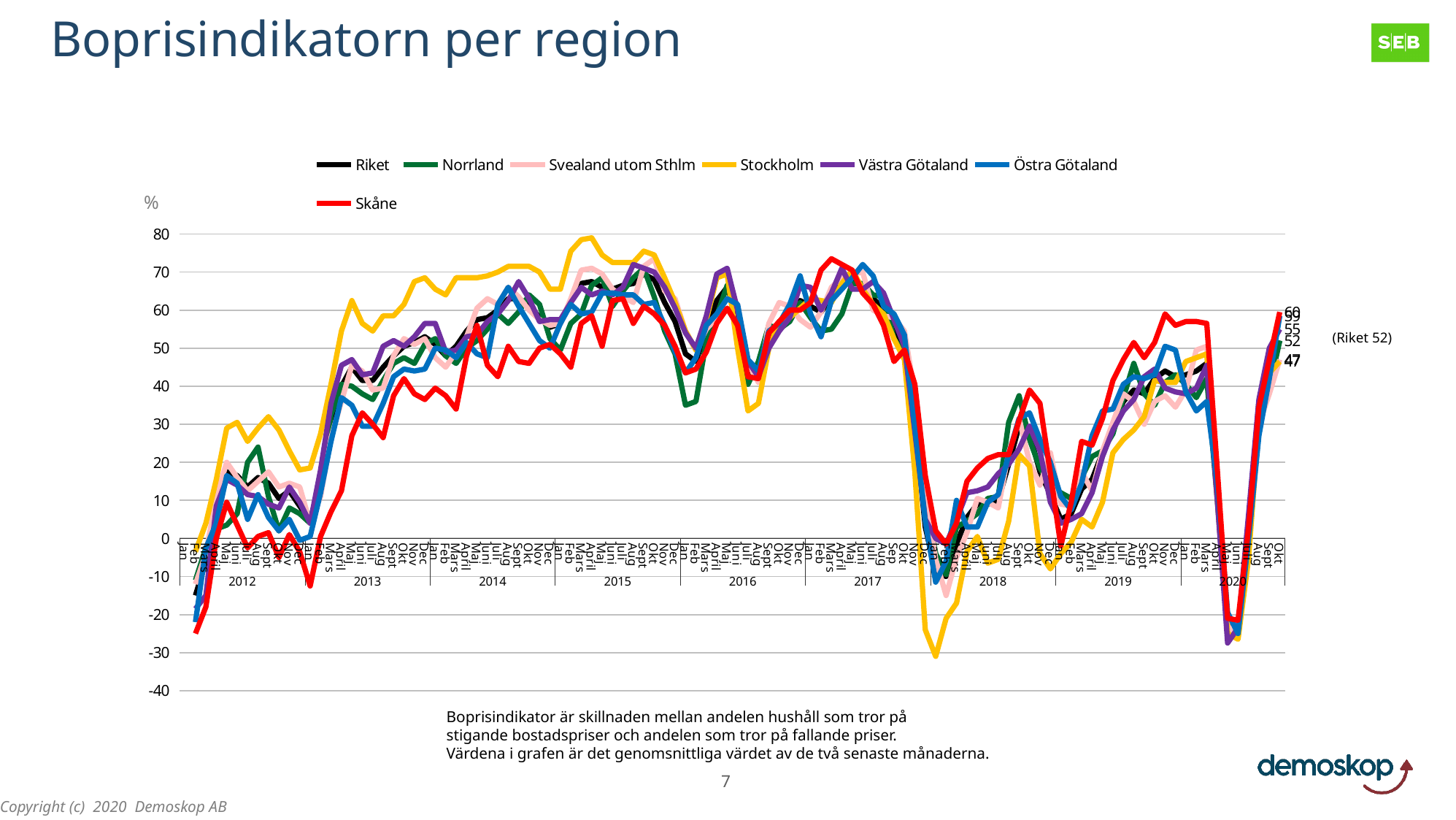
Which series is drawn in red? Skåne What is the unit shown on the y axis? % Did the values rise or fall between mid-2020 and Okt 2020? rise How many series does the legend list? 7 What is the latest value for Riket, as noted on the slide? 52 Which series reaches the highest value on the chart, around early 2015? Stockholm What kind of chart is shown on the slide? line chart Is the value for Stockholm at its peak in early 2015 greater or less than 70? greater Which series is drawn in yellow? Stockholm Is the value for Stockholm at its lowest point around the end of 2017 greater or less than -20? less Is the value for Skåne at the end of the series (Okt 2020) greater or less than 50? greater Which series reaches the lowest value on the chart, around the end of 2017? Stockholm